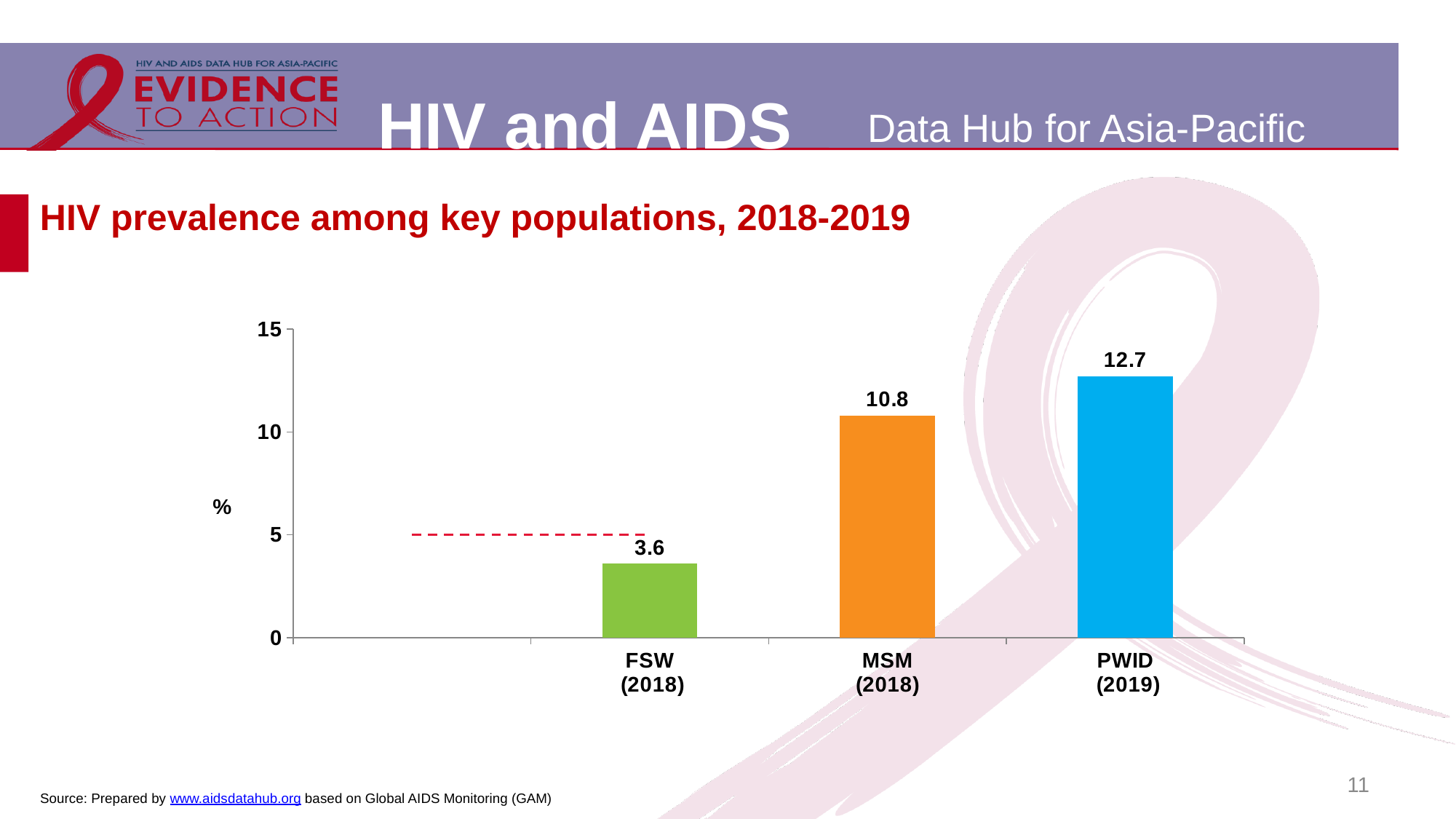
Which is larger, the HIV prevalence for MSM (2018) or for FSW (2018)? MSM (2018) What is the HIV prevalence value shown for MSM (2018)? 10.8 Which key population has the lowest HIV prevalence on the chart? FSW (2018) What is the HIV prevalence value shown for PWID (2019)? 12.7 What is the title of the chart on the slide? HIV prevalence among key populations, 2018-2019 Is the value for FSW (2018) greater or less than 5? less What is the difference between the HIV prevalence for MSM (2018) and FSW (2018)? 7.2 What is the difference between the HIV prevalence for PWID (2019) and MSM (2018)? 1.9 Which key population has the highest HIV prevalence on the chart? PWID (2019) What is the HIV prevalence value shown for FSW (2018)? 3.6 How many key populations are shown as bars on the chart? 3 What kind of chart is shown on the slide? bar chart